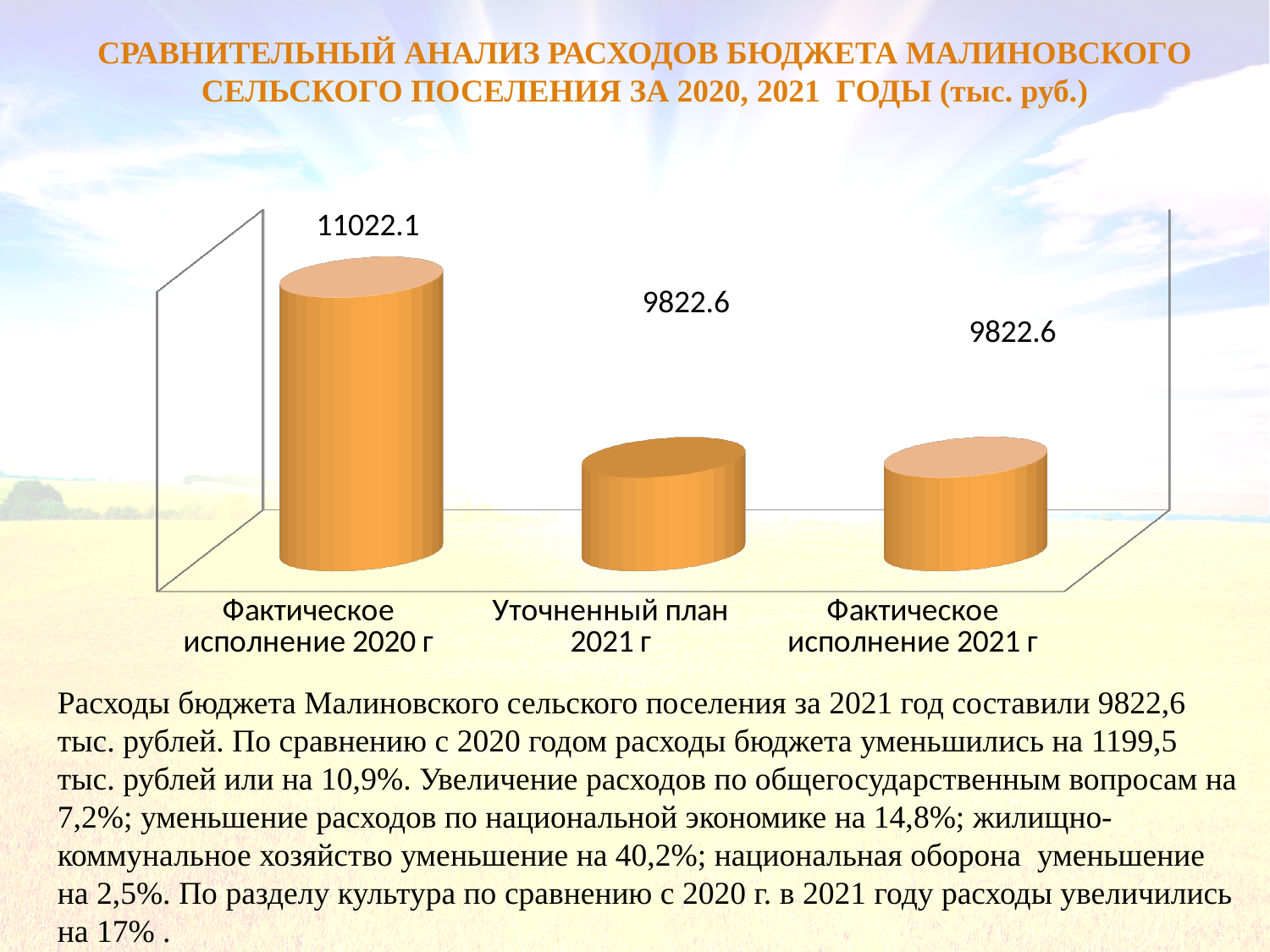
Which is larger: the value for Фактическое исполнение 2020 г or the value for Уточненный план 2021 г? Фактическое исполнение 2020 г Is the value for Уточненный план 2021 г larger than, smaller than, or equal to the value for Фактическое исполнение 2021 г? equal What is the value for Уточненный план 2021 г? 9822.6 In what units are the values on the chart given, according to the slide title? тыс. руб. What colour are the bars on the chart? orange How many categories are shown on the chart? 3 What kind of chart is shown on the slide? bar chart Which category has the highest value? Фактическое исполнение 2020 г What is the value for Фактическое исполнение 2020 г? 11022.1 Does the value rise or fall from Фактическое исполнение 2020 г to Уточненный план 2021 г? fall What is the value for Фактическое исполнение 2021 г? 9822.6 What is the difference between the value for Фактическое исполнение 2020 г and the value for Фактическое исполнение 2021 г? 1199.5